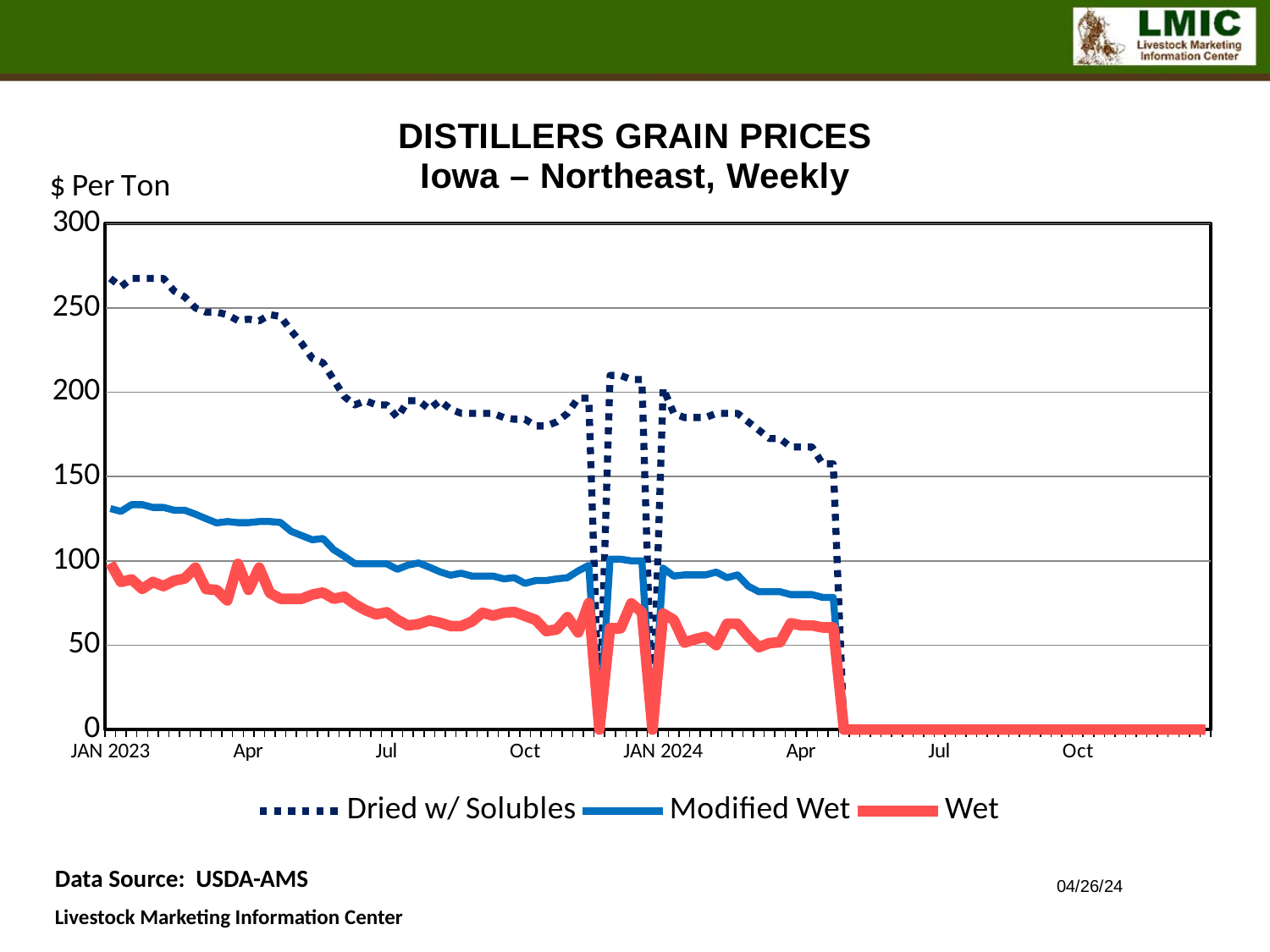
Is the value for Modified Wet at Apr 2024 greater or less than 100? less Is the value for Dried w/ Solubles at JAN 2023 greater or less than 250? greater Does the Dried w/ Solubles series rise or fall from JAN 2023 to Jul 2023? fall Is the value for Dried w/ Solubles at Jul 2023 greater or less than 250? less What is the label on the vertical axis of the chart? $ Per Ton Which series has the lowest value at JAN 2023? Wet What kind of chart is shown on the slide? Line chart Which series has the highest value at JAN 2023? Dried w/ Solubles Which series is drawn with a dashed line in the legend? Dried w/ Solubles How many series does the legend list? 3